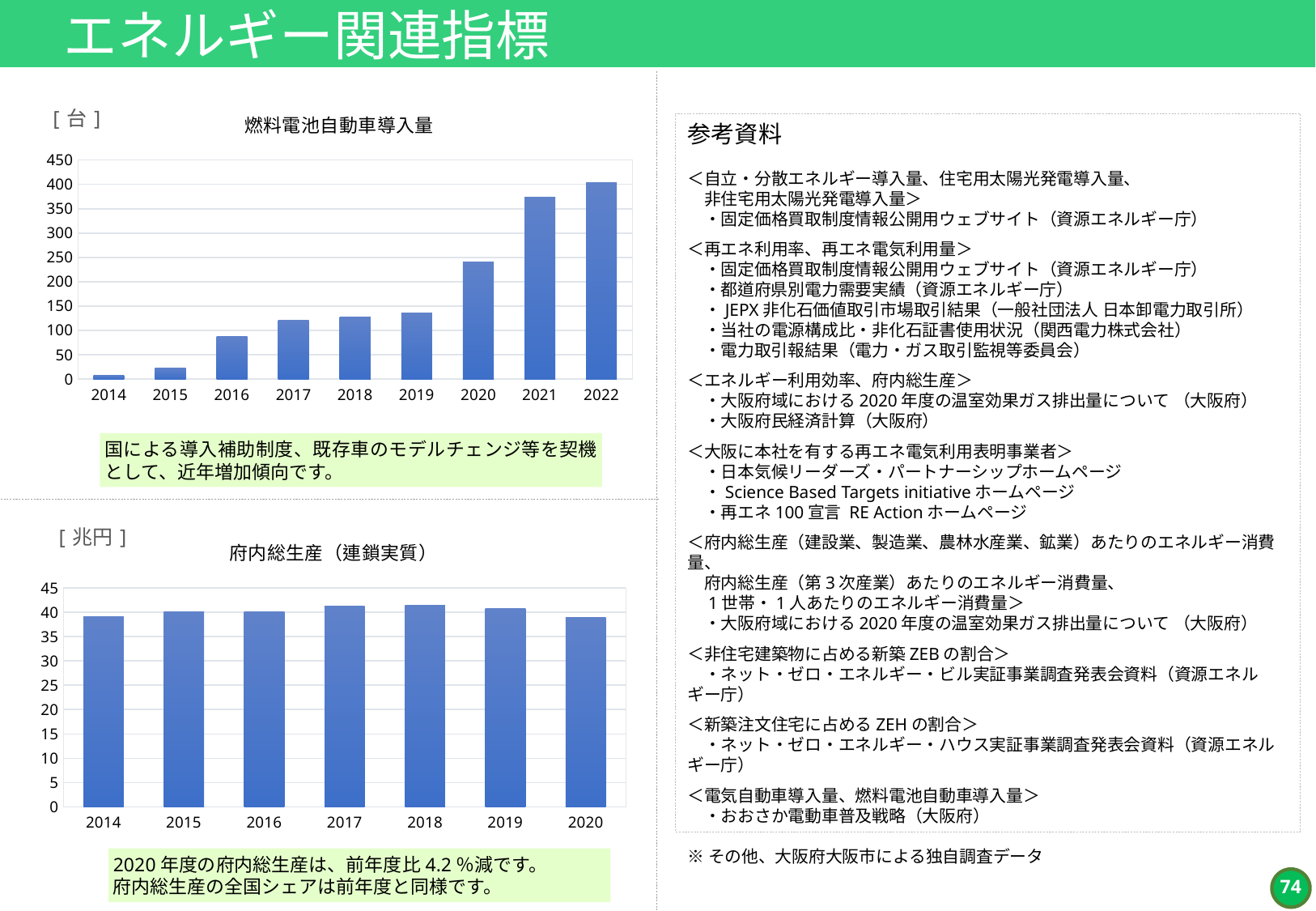
How many years are shown on the x axis of the 燃料電池自動車導入量 chart? 9 How many years are shown on the x axis of the 府内総生産（連鎖実質） chart? 7 In the 燃料電池自動車導入量 chart, is the value for 2016 greater or less than 100? less In the 燃料電池自動車導入量 chart, which is larger, the value for 2019 or the value for 2020? 2020 In the 燃料電池自動車導入量 chart, which year has the highest value? 2022 What unit is shown for the 燃料電池自動車導入量 chart? 台 What type of chart is the 燃料電池自動車導入量 chart? bar chart In the 燃料電池自動車導入量 chart, is the value for 2021 greater or less than 350? greater Do the values in the 燃料電池自動車導入量 chart generally rise or fall from 2014 to 2022? rise In the 燃料電池自動車導入量 chart, which year has the lowest value? 2014 In the 燃料電池自動車導入量 chart, is the value for 2020 greater or less than 200? greater